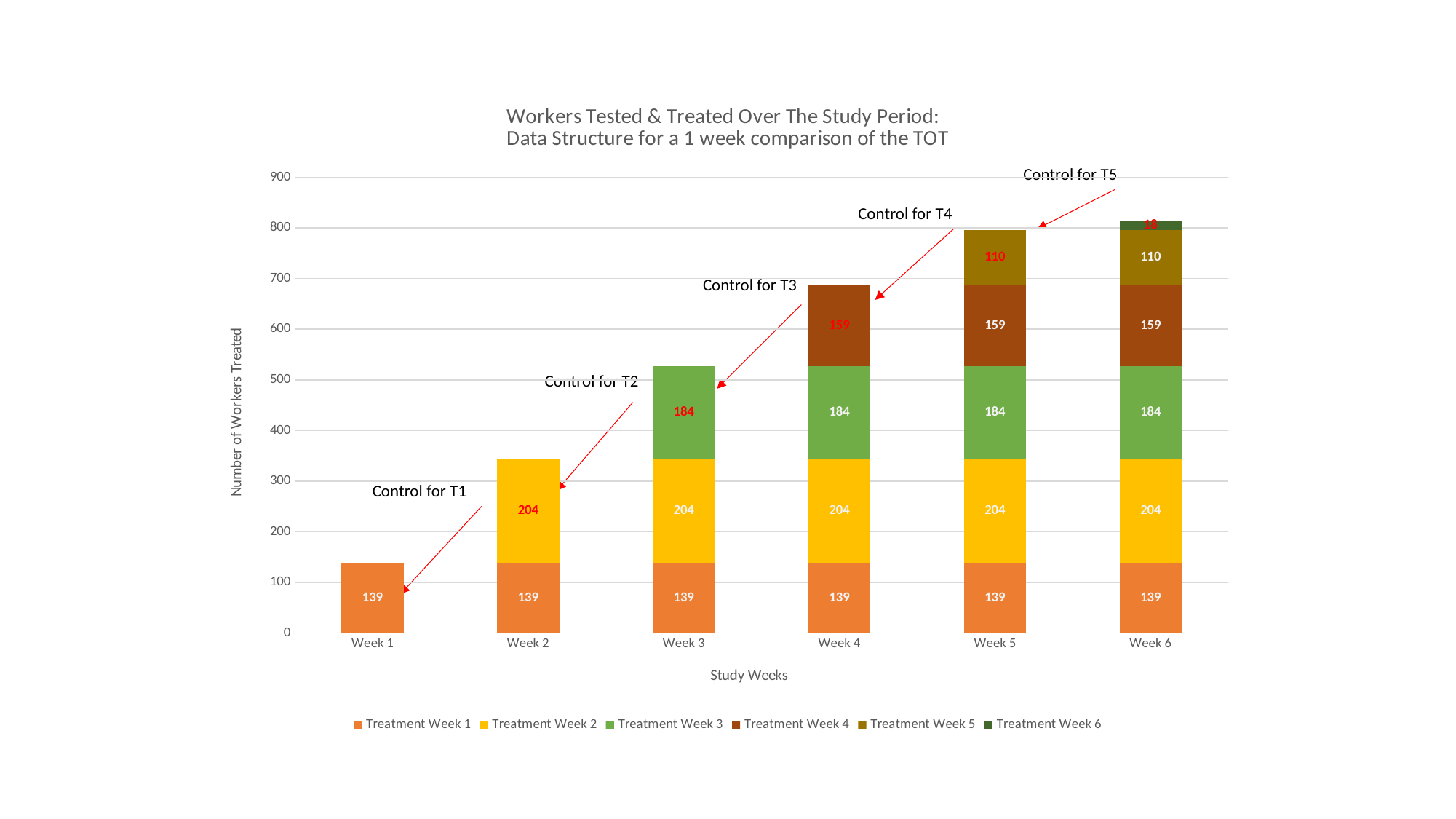
How many series does the legend list? 6 What is the value of Treatment Week 3 in the Week 4 bar? 184 How many study weeks are shown on the x axis? 6 What is the total of the stacked bar for Week 2? 343 Which study week has the shortest stacked bar? Week 1 In the Week 5 bar, what is the difference between Treatment Week 2 and Treatment Week 4? 45 What kind of chart is shown on the slide? Stacked bar chart In the Week 6 bar, which is larger: Treatment Week 2 or Treatment Week 3? Treatment Week 2 Is the total for the Week 5 bar greater or less than 700? greater What is the value of Treatment Week 5 in the Week 5 bar? 110 What is the total of the stacked bar for Week 3? 527 What is the value of Treatment Week 1 in the Week 3 bar? 139